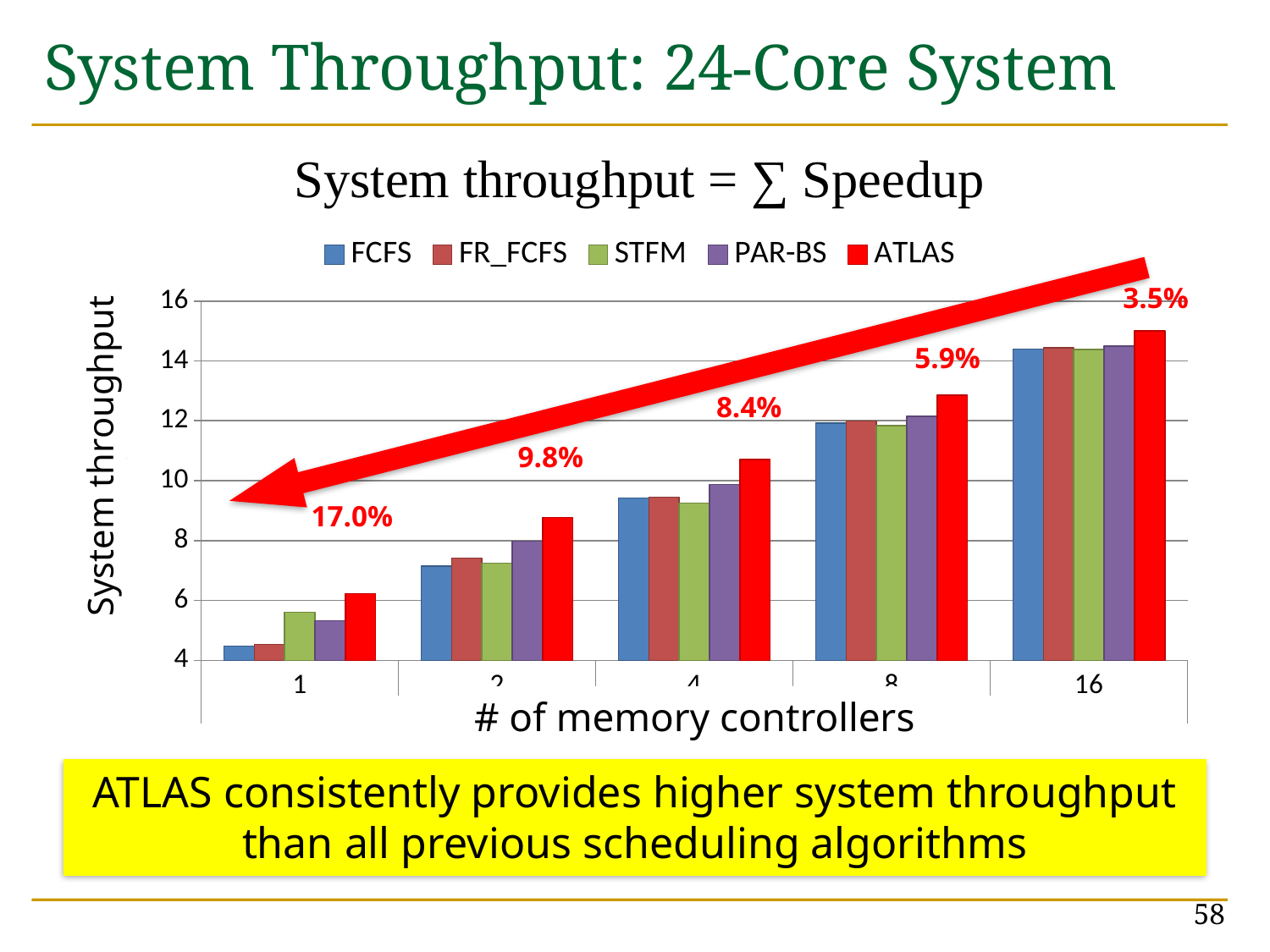
How many series does the legend list? 5 What colour represents ATLAS in the legend? red Is the system throughput of ATLAS at 1 memory controller greater or less than 8? less Is the system throughput of ATLAS at 16 memory controllers greater or less than 14? greater Is the system throughput of FCFS at 16 memory controllers greater or less than 12? greater At 2 memory controllers, which has higher system throughput, STFM or PAR-BS? PAR-BS Which scheduling algorithm has the highest system throughput at 2 memory controllers? ATLAS What percentage improvement is annotated above the bars for 1 memory controller? 17.0% What kind of chart is shown on the slide? bar chart Does the system throughput of ATLAS rise or fall as the number of memory controllers increases? rise Which scheduling algorithm has the highest system throughput at 16 memory controllers? ATLAS How many groups of bars (memory controller counts) are plotted along the x axis? 5